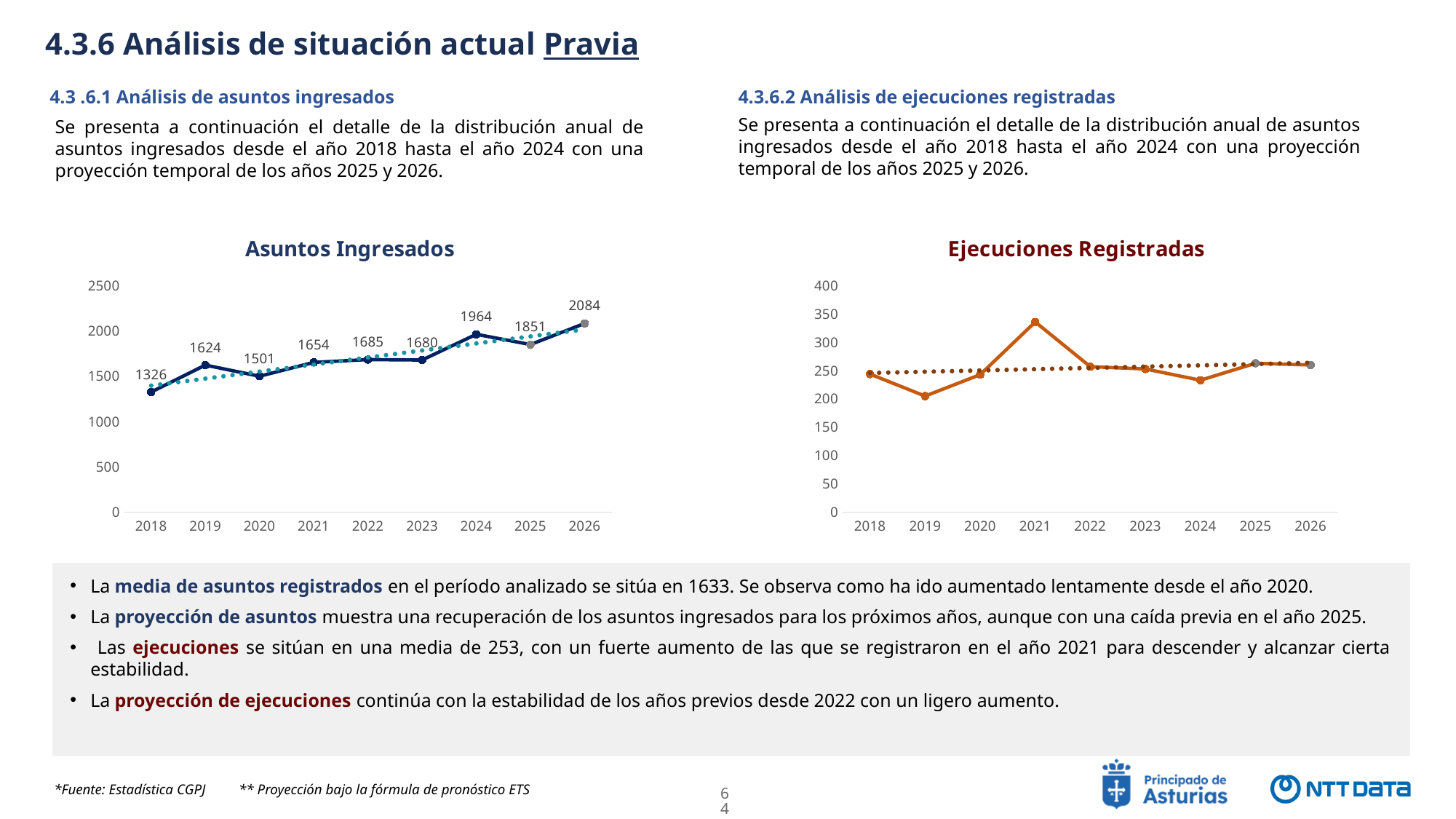
What kind of chart is the Ejecuciones Registradas chart? line chart In the Ejecuciones Registradas chart, is the value for 2019 greater or less than 250? less In the Ejecuciones Registradas chart, which year has the highest value? 2021 How many years are plotted on the x axis of the Asuntos Ingresados chart? 9 In the Asuntos Ingresados chart, what is the value for 2024? 1964 In the Ejecuciones Registradas chart, is the value for 2021 greater or less than 300? greater In the Asuntos Ingresados chart, what is the value for 2018? 1326 In the Ejecuciones Registradas chart, which year has the lowest value? 2019 In the Asuntos Ingresados chart, what is the difference between the values for 2026 and 2025? 233 In the Asuntos Ingresados chart, which year has the larger value, 2019 or 2020? 2019 In the Asuntos Ingresados chart, which year has the lowest value? 2018 In the Asuntos Ingresados chart, which year has the highest value? 2026